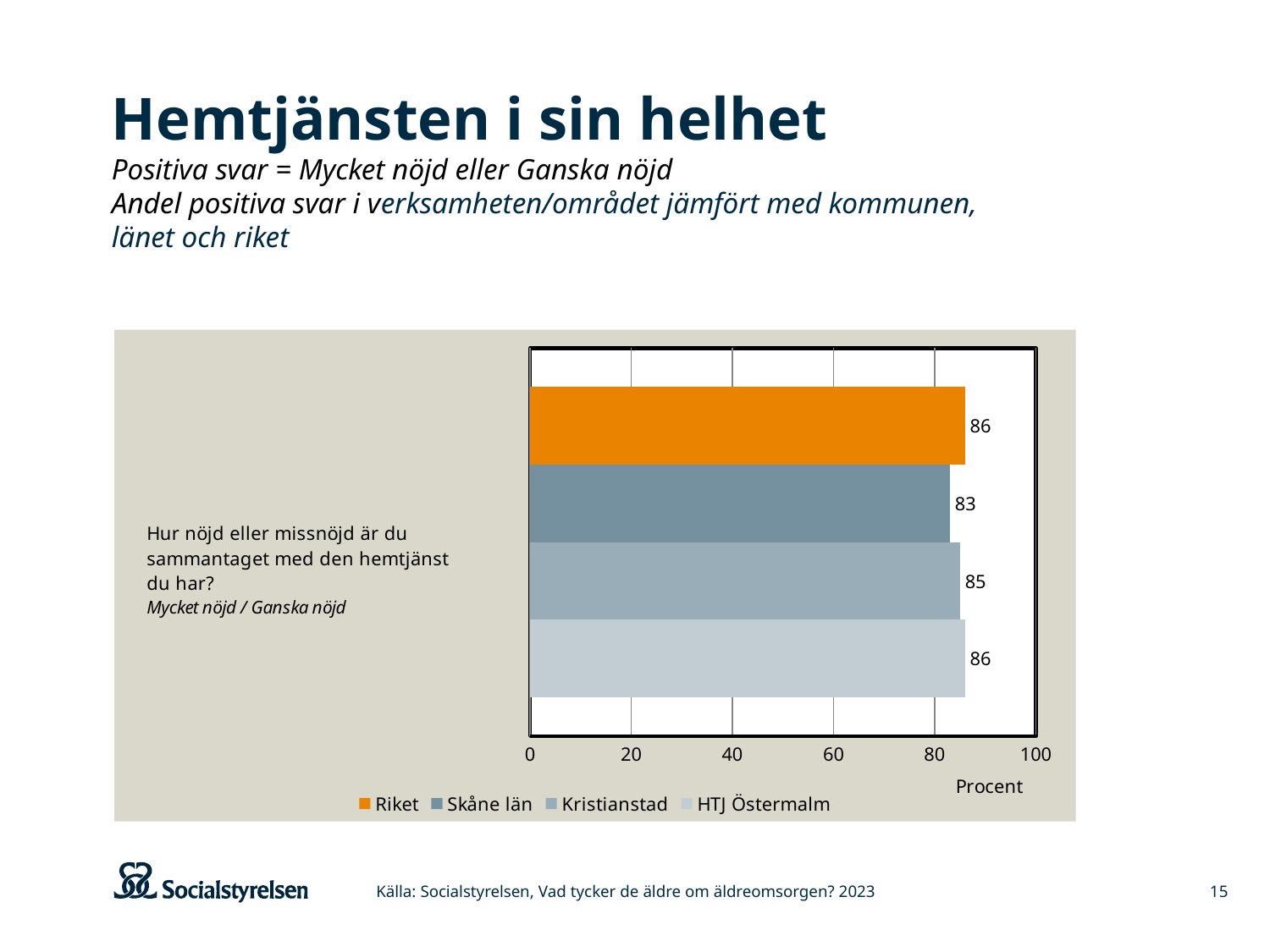
What is the value for Riket? 86 What is the difference between the values for Kristianstad and Skåne län? 2 Which series has the lowest value? Skåne län How many series does the legend list? 4 What is the value for HTJ Östermalm? 86 What is the value for Skåne län? 83 Is the value for Skåne län greater or less than 80? greater Which is larger, the value for Kristianstad or the value for Skåne län? Kristianstad What is the difference between the values for Riket and Skåne län? 3 What kind of chart is shown on the slide? Bar chart What is the value for Kristianstad? 85 What is the label on the horizontal axis of the chart? Procent